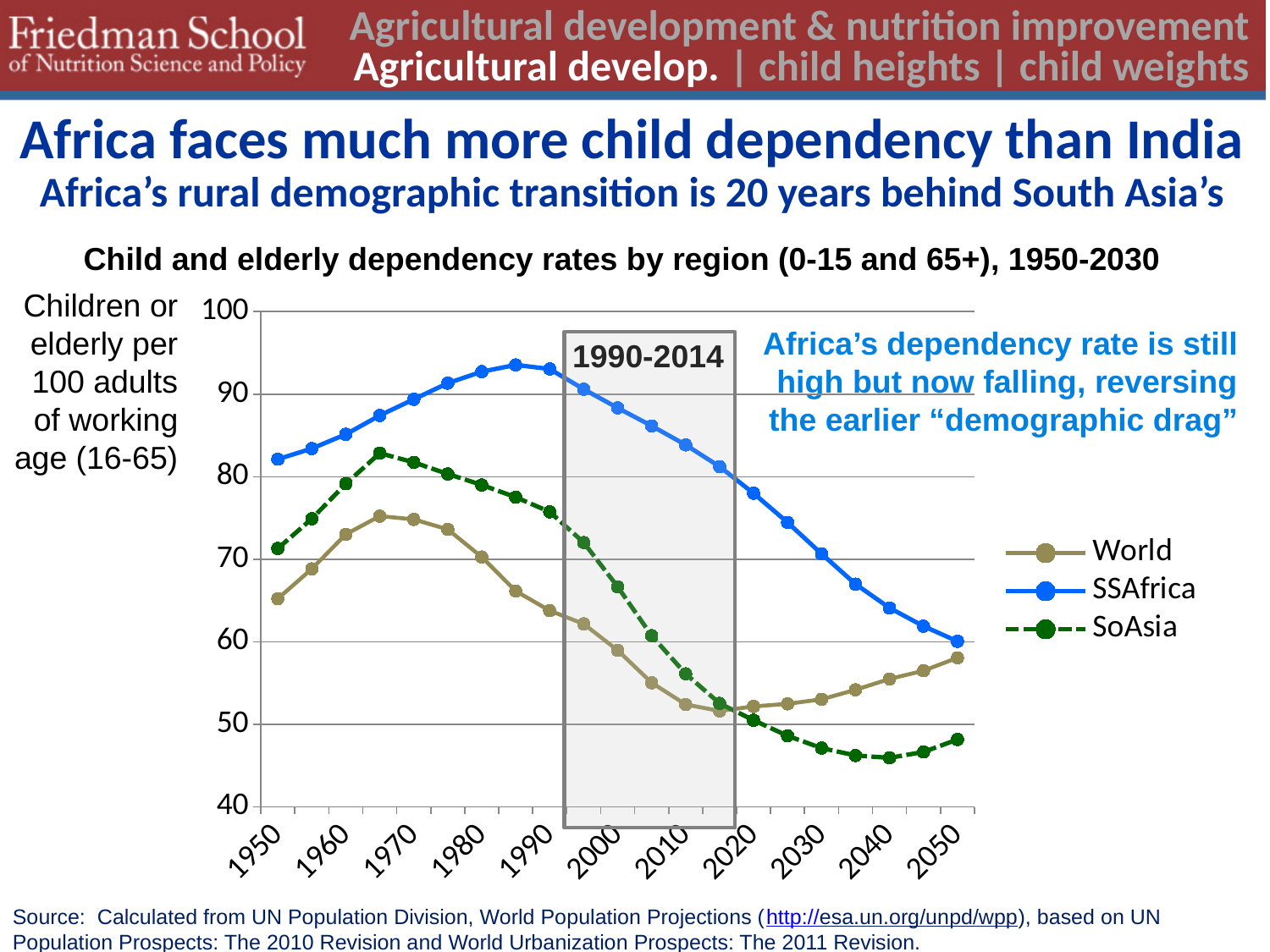
Is the value for SoAsia in 2040 greater or less than 50? less What kind of chart is shown on the slide? line chart Is the value for SSAfrica in 1990 greater or less than 90? greater In 1980, which is larger, the value for SoAsia or the value for World? SoAsia Which series are listed in the legend? World, SSAfrica, SoAsia How many series does the legend list? 3 What period is marked by the shaded box on the chart? 1990-2014 Which series has the highest value in 2020? SSAfrica Is the value for SSAfrica in 1950 greater or less than 80? greater Which series has the lowest value in 2050? SoAsia Does the SSAfrica series rise or fall between 1990 and 2050? fall